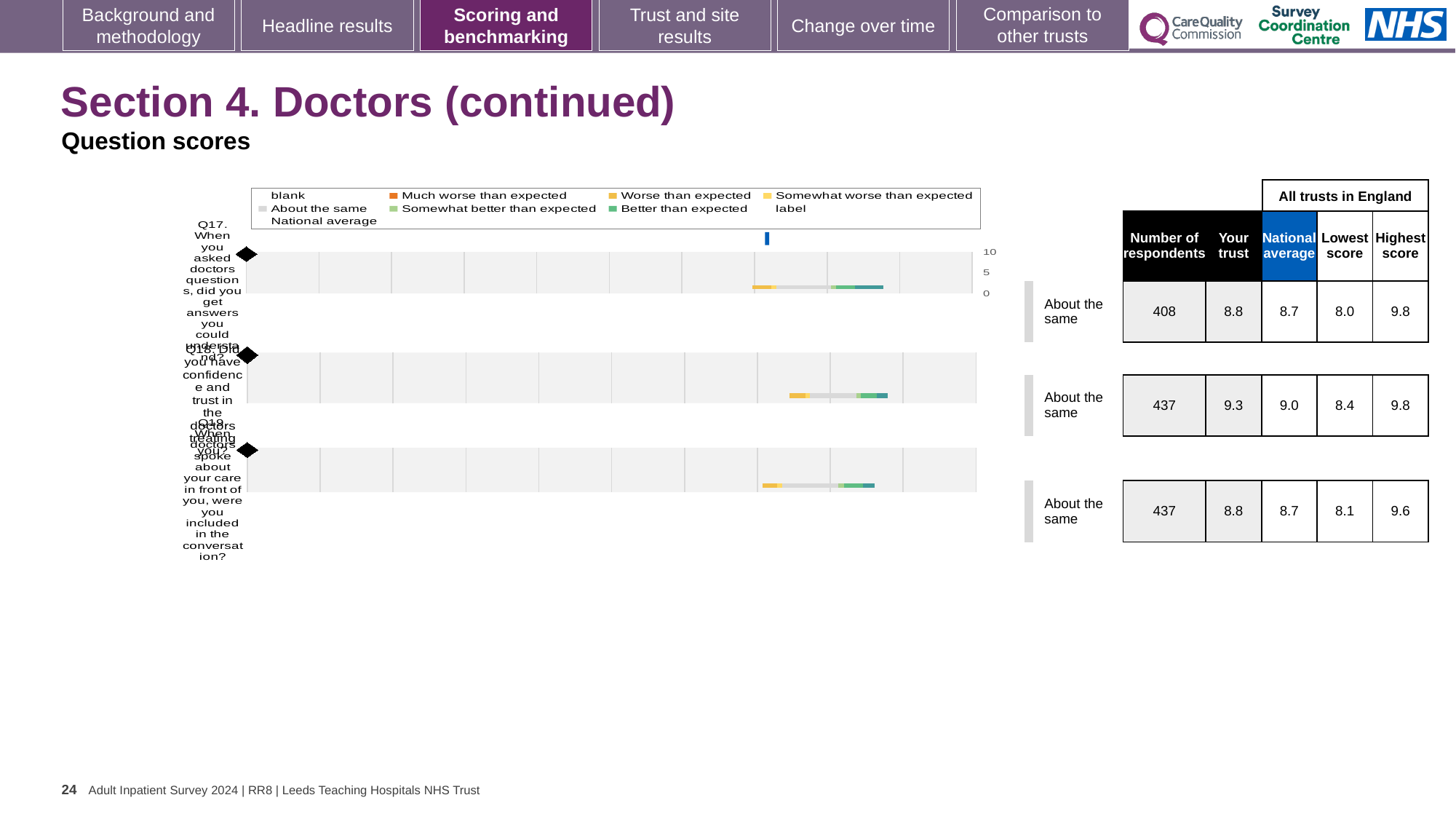
What is the 'Your trust' score for Q17 (When you asked doctors questions, did you get answers you could understand)? 8.8 What is the highest score among all trusts in England for Q17? 9.8 What kind of chart is used for each question score? bar chart What benchmark category is shown for Q17? About the same What is the national average for Q19 (When doctors spoke about your care in front of you, were you included in the conversation)? 8.7 Which of the three questions has the highest 'Your trust' score? Q18 For Q19, which is larger: the 'Your trust' score or the national average? Your trust What is the 'Your trust' score for Q18 (Did you have confidence and trust in the doctors treating you)? 9.3 In the legend, which colour represents 'Much worse than expected'? orange What is the difference between the 'Your trust' score and the national average for Q18? 0.3 How many respondents answered Q18? 437 How many question charts (Q17, Q18, Q19) are shown on the slide? 3